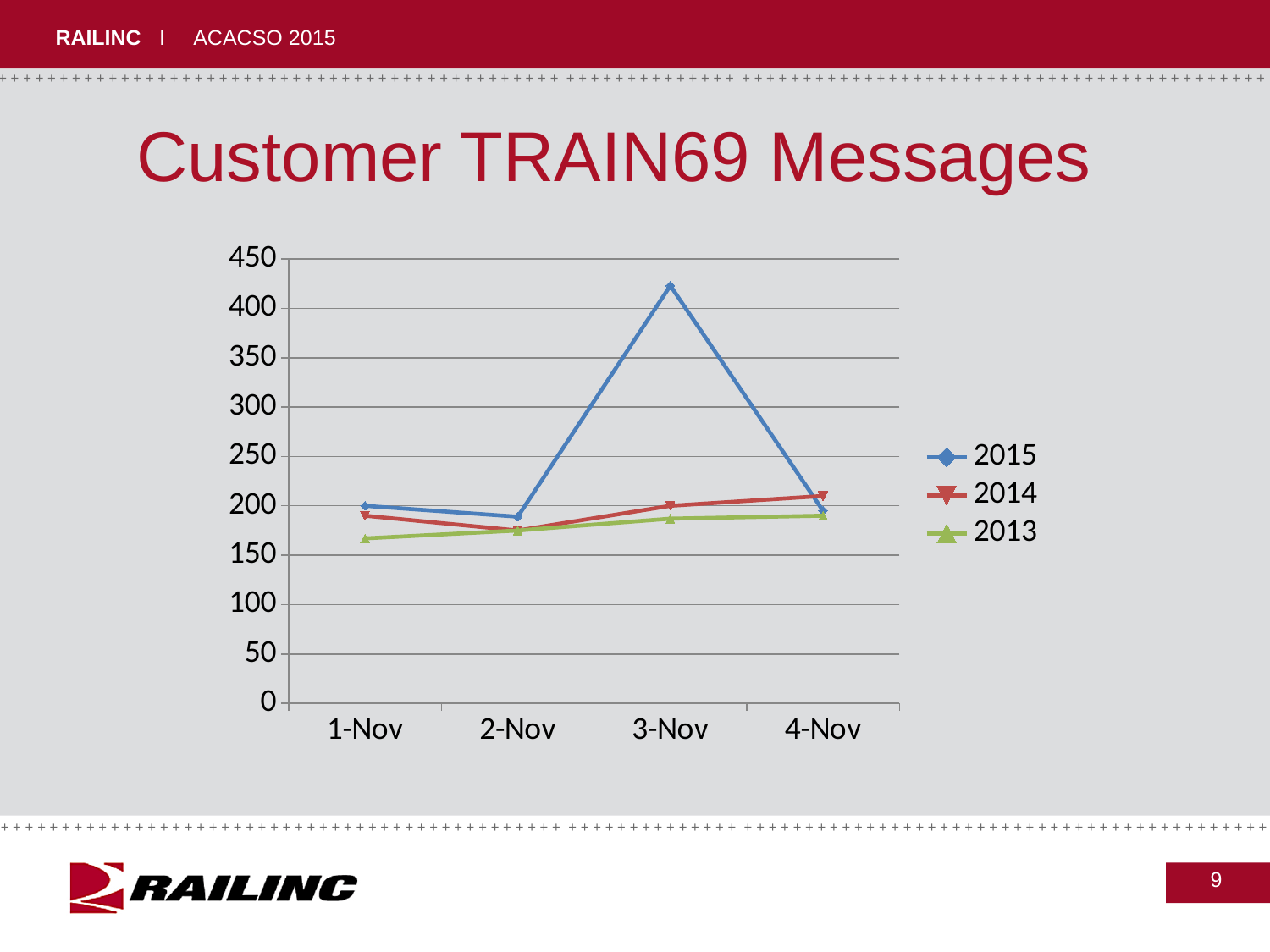
On 3-Nov, which series has the larger value, 2015 or 2014? 2015 Is the value for 2014 on 4-Nov greater or less than 200? greater On which date does the 2013 series have its lowest value? 1-Nov What kind of chart is shown on the slide? line chart How many dates are shown along the x axis? 4 Is the value for 2015 on 3-Nov greater or less than 400? greater Is the value for 2013 on 1-Nov greater or less than 200? less How many series does the legend list? 3 On 1-Nov, which series has the larger value, 2015 or 2013? 2015 Do the values for the 2013 series rise or fall from 1-Nov to 4-Nov? rise What is the title of the chart on the slide? Customer TRAIN69 Messages On which date does the 2015 series reach its highest value? 3-Nov